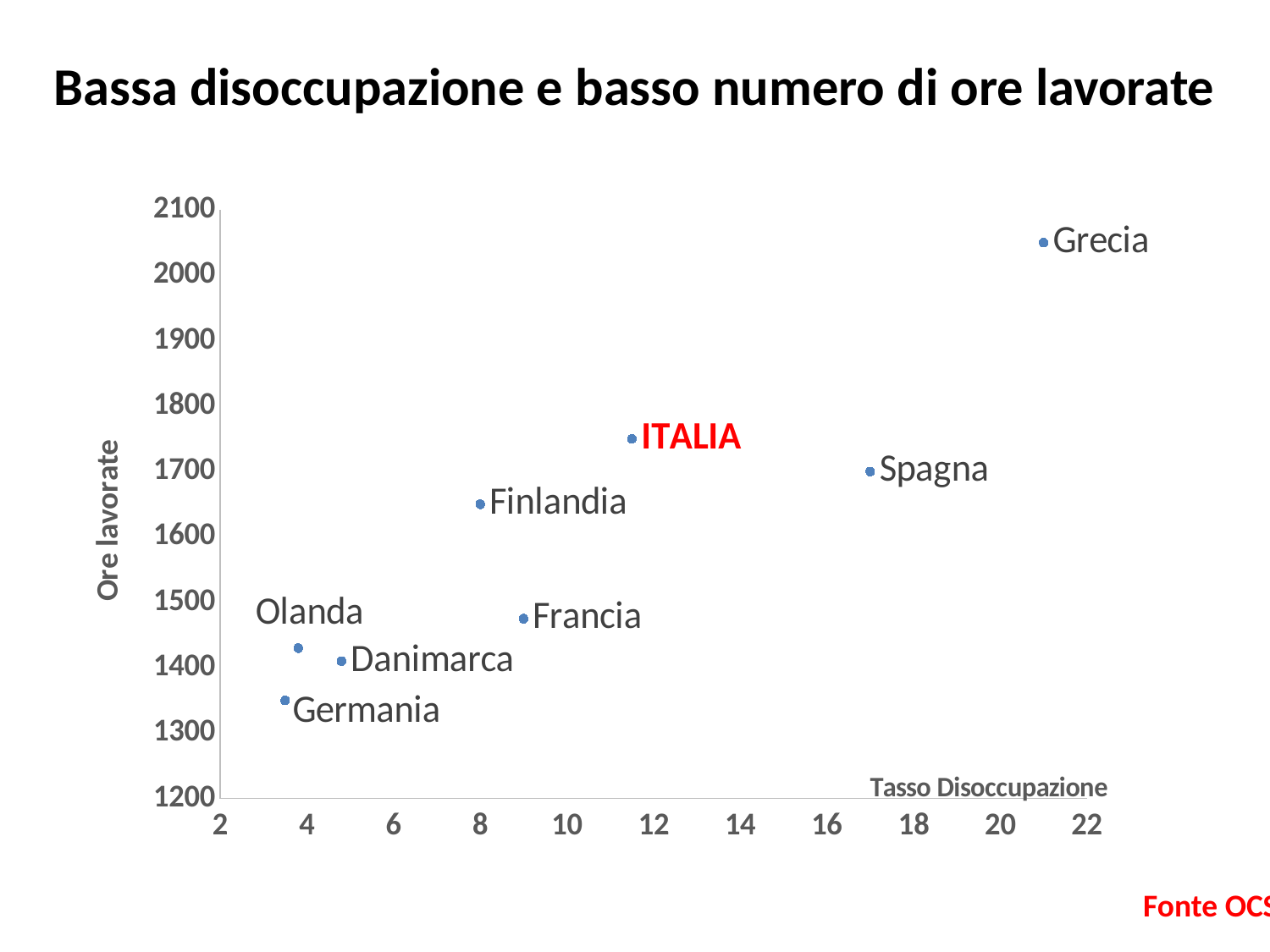
Is the Ore lavorate value for ITALIA greater or less than 1700? greater What kind of chart is shown on the slide? scatter chart Is the Ore lavorate value for Grecia greater or less than 2000? greater How many countries are plotted on the chart? 8 Which country has the highest Tasso Disoccupazione? Grecia Is the Tasso Disoccupazione value for Spagna greater or less than 16? greater What is the title of the slide's chart? Bassa disoccupazione e basso numero di ore lavorate Which country has the lowest value of Ore lavorate? Germania Which country has the highest value of Ore lavorate? Grecia Which has more Ore lavorate, Finlandia or Francia? Finlandia Which has more Ore lavorate, Grecia or Spagna? Grecia